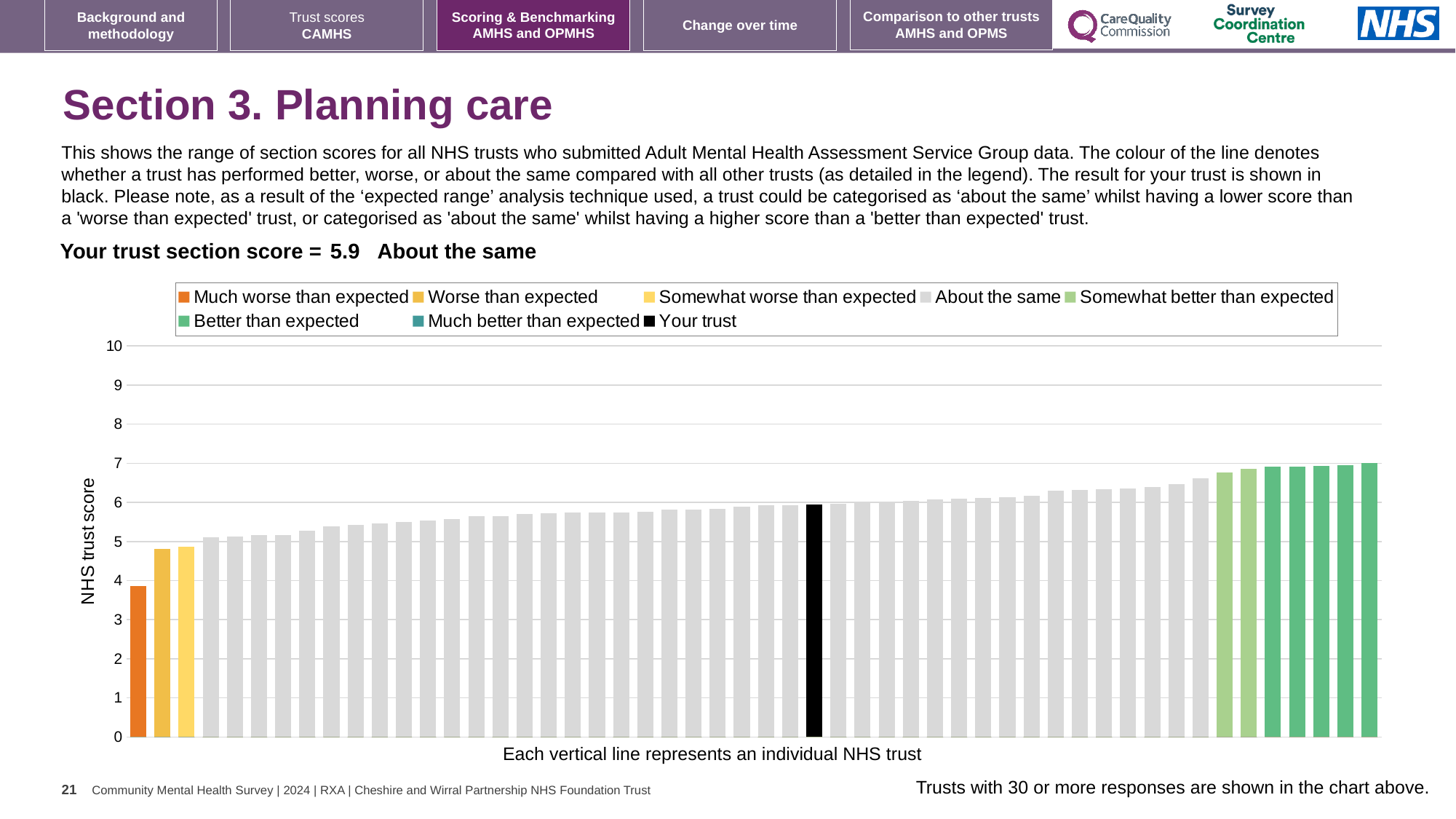
What colour is the bar representing your trust? black Is the value of the tallest bar in the chart greater or less than 8? less What is the label on the vertical axis of the chart? NHS trust score Do the bar values rise or fall from left to right along the x axis? rise How many bars are coloured orange ('Much worse than expected')? 1 What kind of chart is shown on the slide? bar chart What is the section score for your trust? 5.9 Which is larger, the black 'Your trust' bar or the orange 'Much worse than expected' bar? Your trust How many entries does the chart legend list? 8 Is the value of the orange 'Much worse than expected' bar greater or less than 5? less Is the value of the black 'Your trust' bar greater or less than 5? greater